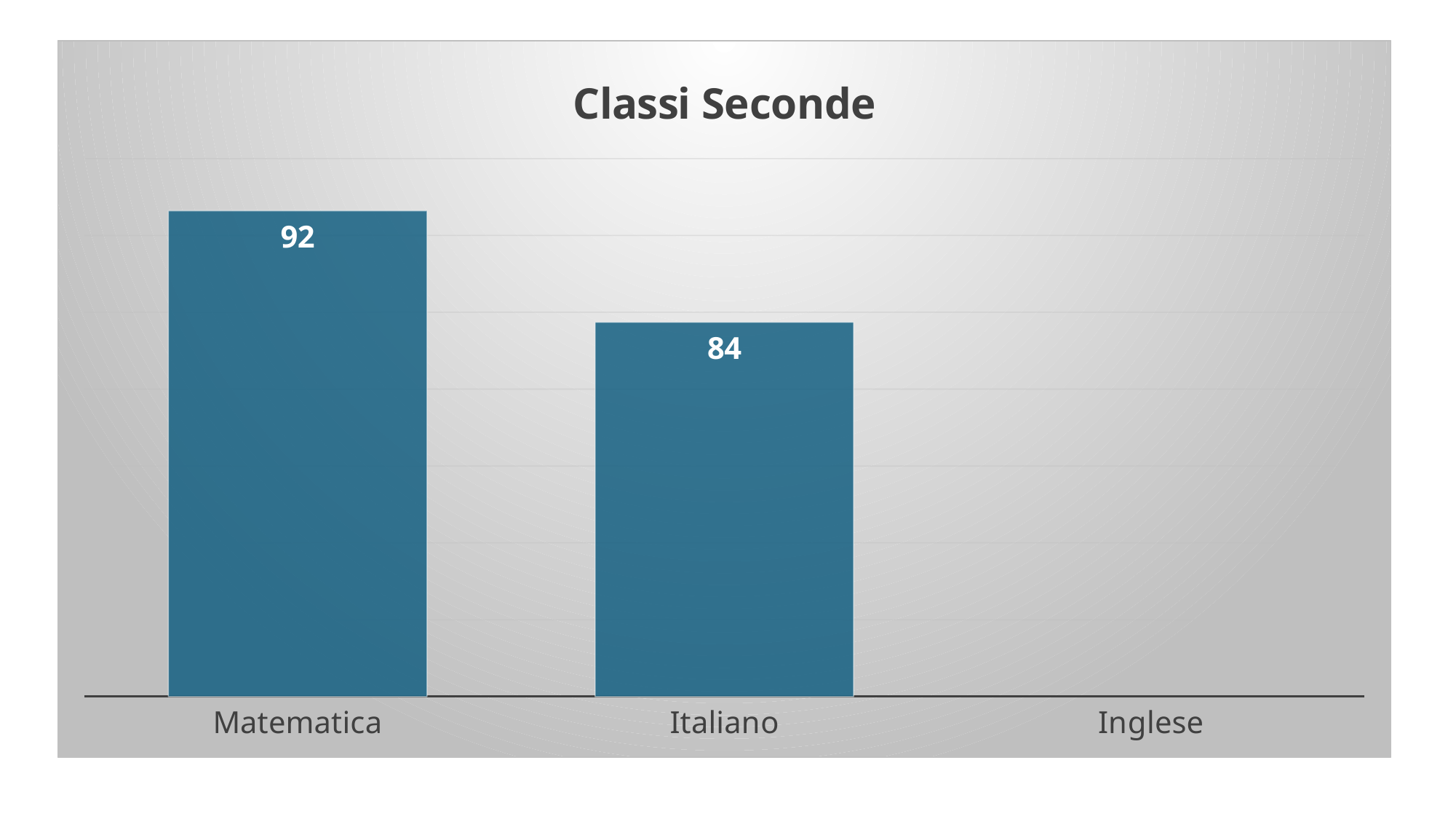
Do the values fall from Matematica to Italiano? Yes Which category has the highest value? Matematica What is the value for Italiano? 84 What kind of chart is this? bar chart What is the value for Matematica? 92 What is the difference between the values for Matematica and Italiano? 8 How many categories are shown on the x axis? 3 Which category has no bar plotted? Inglese Which is larger, the value for Matematica or the value for Italiano? Matematica What is the title of the chart? Classi Seconde